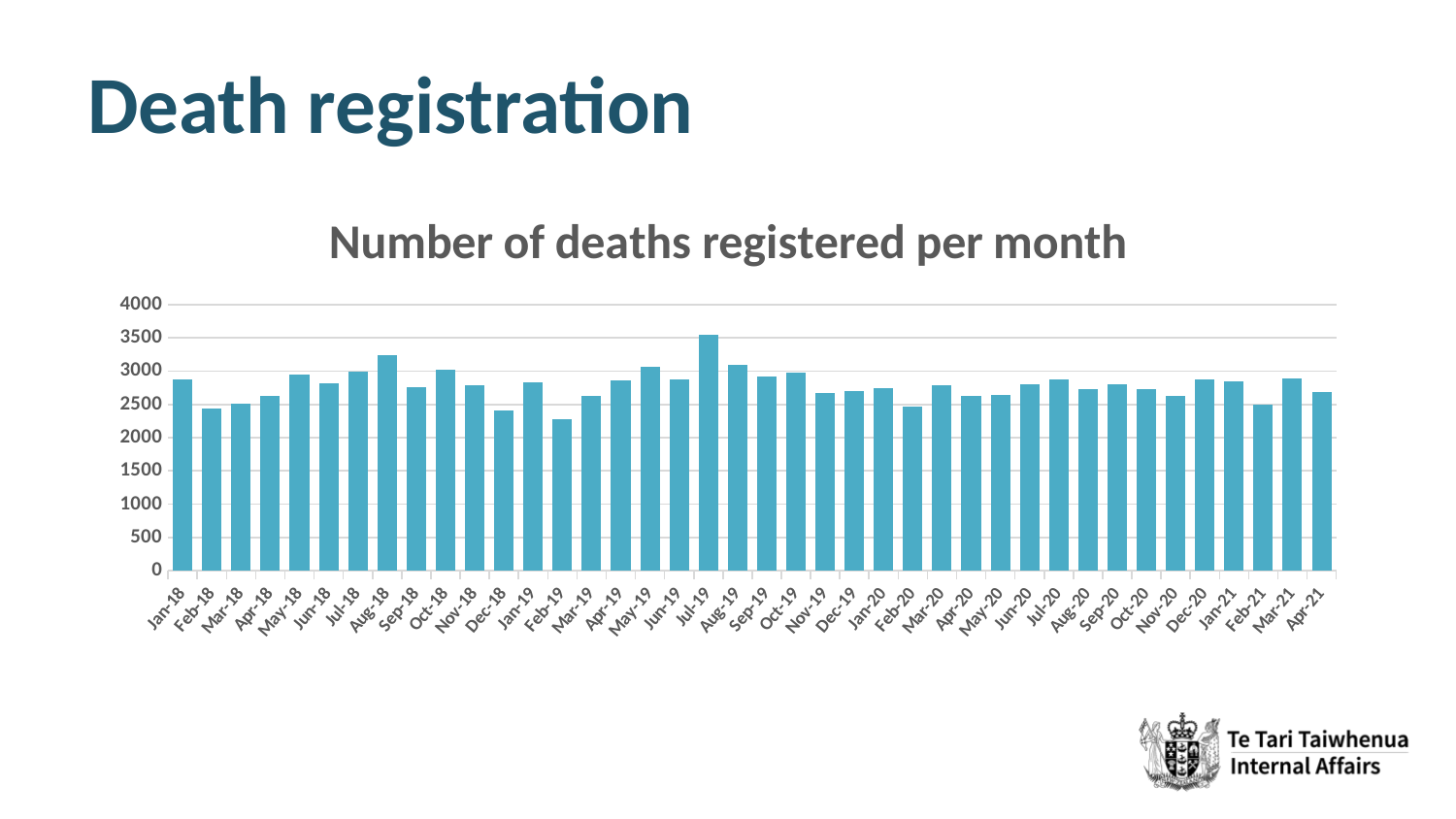
Which month has the highest number of deaths registered? Jul-19 How many months are plotted on the chart? 40 What is the title of the chart? Number of deaths registered per month Which month has the lowest number of deaths registered? Feb-19 Is the value for Jul-19 greater or less than 3000? greater Is the value for Feb-19 greater or less than 2500? less Is the value for Mar-21 greater or less than 2500? greater Which month has the larger value, Jan-19 or Feb-19? Jan-19 What kind of chart is shown on the slide? Bar chart Which month has the larger value, Aug-18 or Oct-18? Aug-18